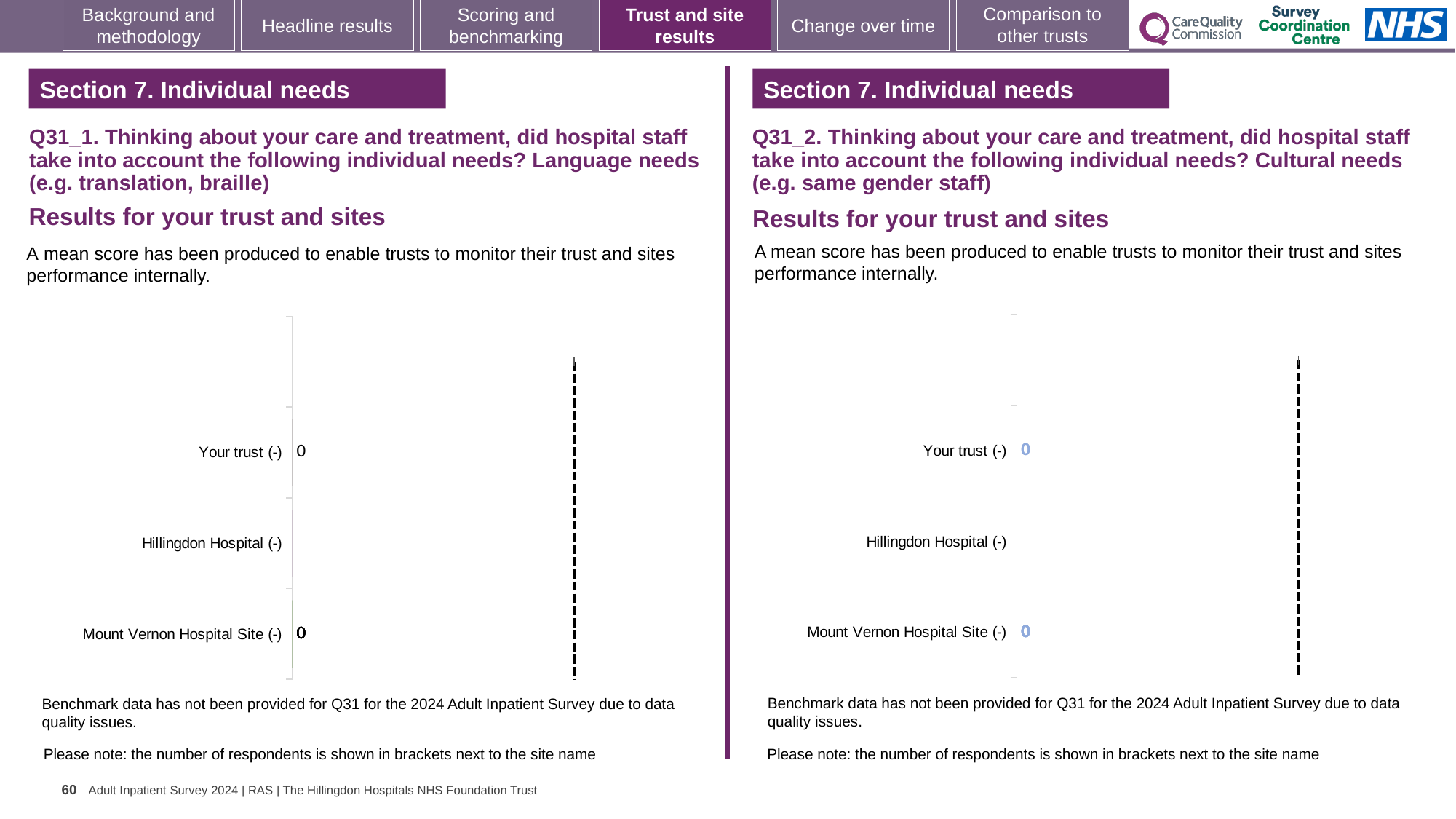
On the right chart (Q31_2, Cultural needs), what value is shown for Mount Vernon Hospital Site (-)? 0 On the right chart (Q31_2, Cultural needs), what value is shown for Your trust (-)? 0 How many categories are listed on the vertical axis of the right chart (Q31_2)? 3 Which category appears at the bottom of the vertical axis on the right chart (Q31_2)? Mount Vernon Hospital Site (-) What kind of chart is used on the left side of the slide (Q31_1)? Bar chart Which category appears at the top of the vertical axis on the left chart (Q31_1)? Your trust (-) On the left chart (Q31_1, Language needs), what value is shown for Your trust (-)? 0 How many categories are listed on the vertical axis of the left chart (Q31_1)? 3 On the left chart (Q31_1, Language needs), what value is shown for Mount Vernon Hospital Site (-)? 0 What is the difference between the values for Your trust (-) and Mount Vernon Hospital Site (-) on the left chart (Q31_1)? 0